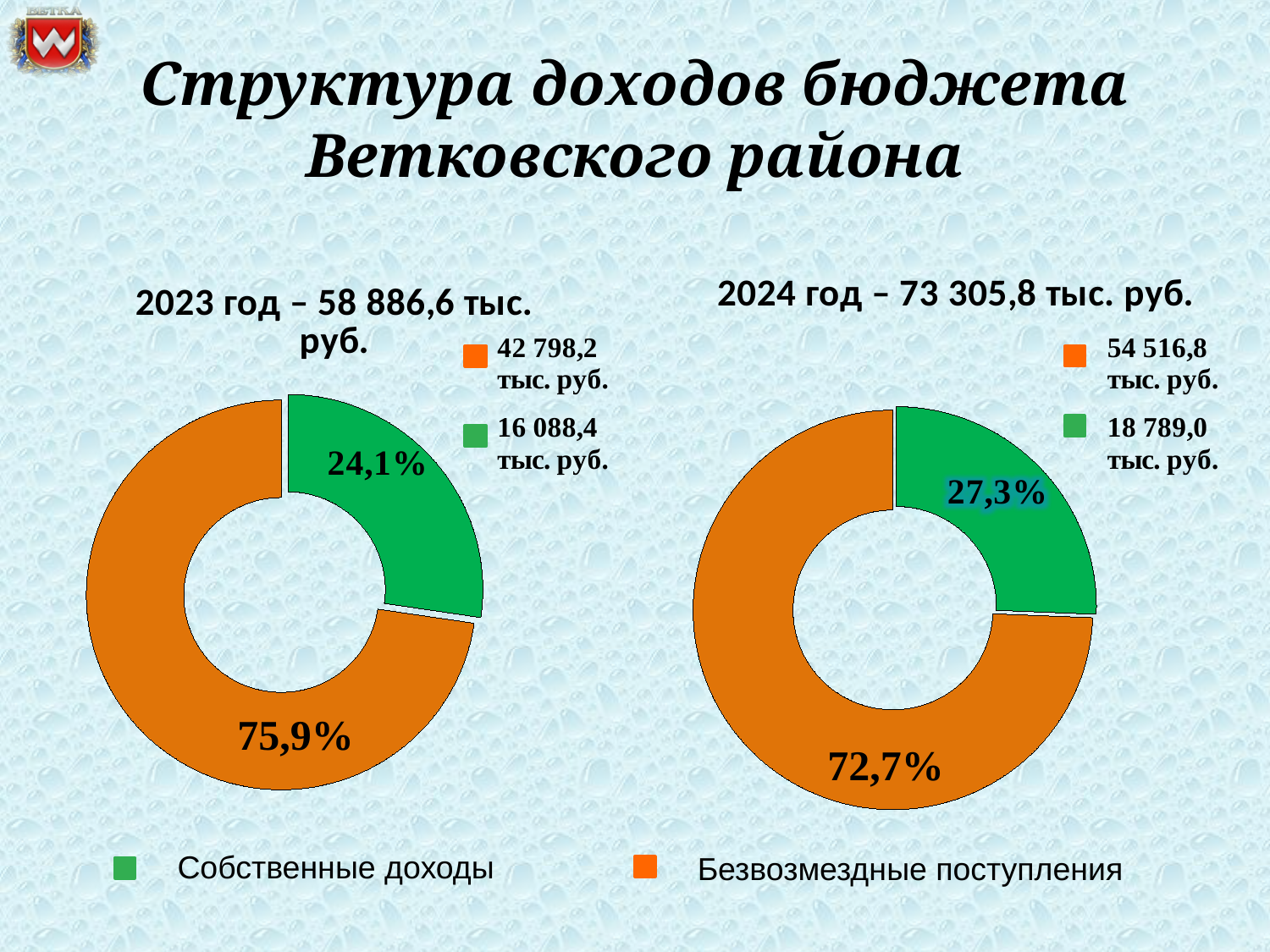
In the 2024 chart, what is the value of Собственные доходы in тыс. руб.? 18 789,0 тыс. руб. In the 2024 chart, what share of the budget revenue is Безвозмездные поступления? 72,7% Which is larger: the share of Собственные доходы in 2023 or in 2024? 2024 In the 2024 chart, which category is the smallest? Собственные доходы In the 2024 chart, what share of the budget revenue is Собственные доходы? 27,3% Which colour represents Собственные доходы in the charts? Green In the 2023 chart, which category is the largest? Безвозмездные поступления What is the total budget revenue shown for 2024? 73 305,8 тыс. руб. In the 2023 chart, what share of the budget revenue is Безвозмездные поступления? 75,9% What type of chart is used on this slide? Pie (donut) chart In the 2023 chart, what is the value of Безвозмездные поступления in тыс. руб.? 42 798,2 тыс. руб.